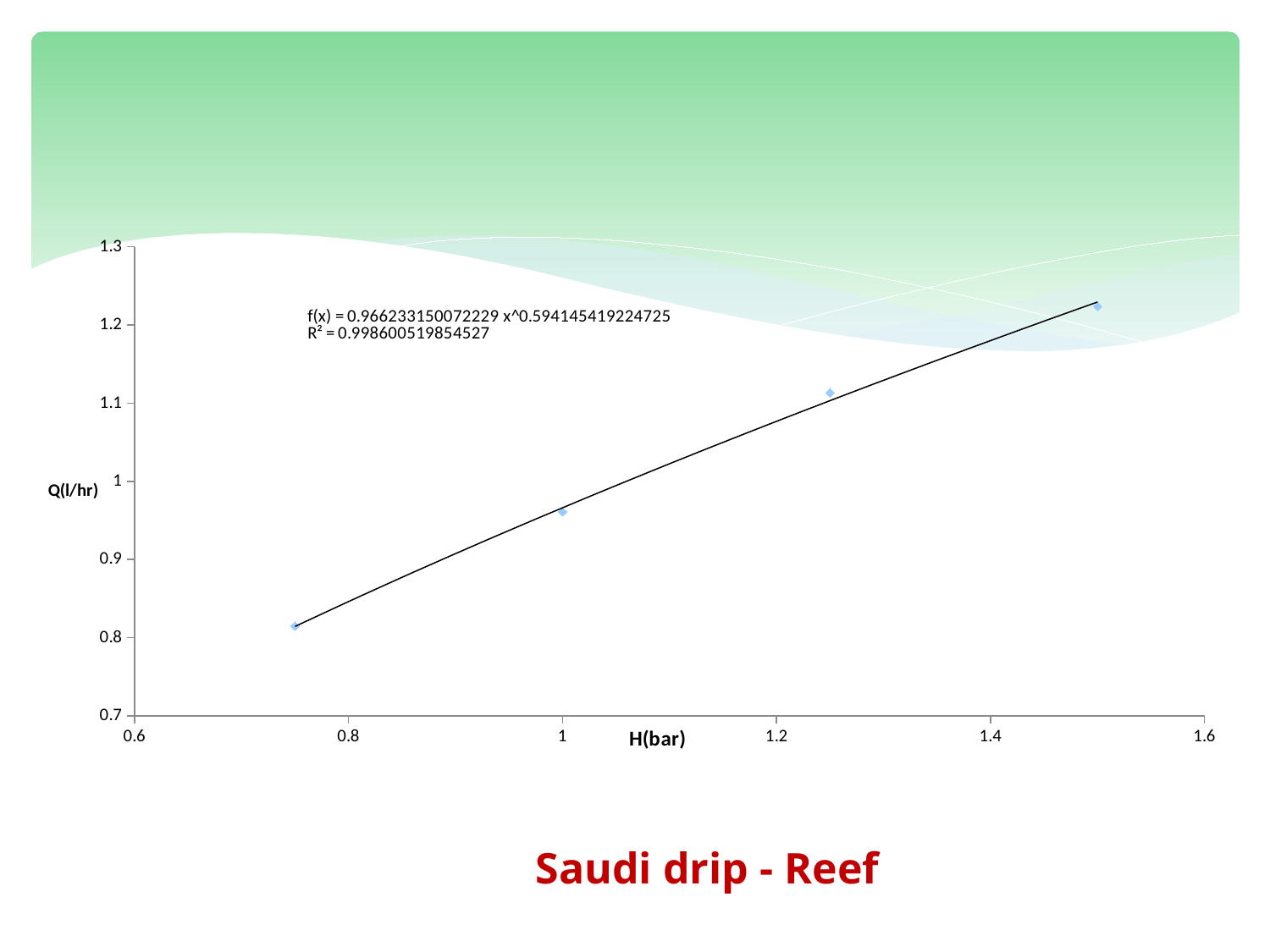
Is the Q(l/hr) value at H = 1.25 bar greater or less than 1? greater Is the Q(l/hr) value at H = 0.75 bar greater or less than 0.9? less How many data points are plotted on the chart? 4 Do the Q(l/hr) values rise or fall as H(bar) increases? rise What is the R² value printed on the chart? 0.998600519854527 What is the label of the horizontal axis? H(bar) What kind of chart is shown on the slide? scatter chart Is the Q(l/hr) value at H = 1.5 bar greater or less than 1.1? greater Which has the larger Q(l/hr) value: the point at H = 1 bar or the point at H = 1.25 bar? H = 1.25 bar